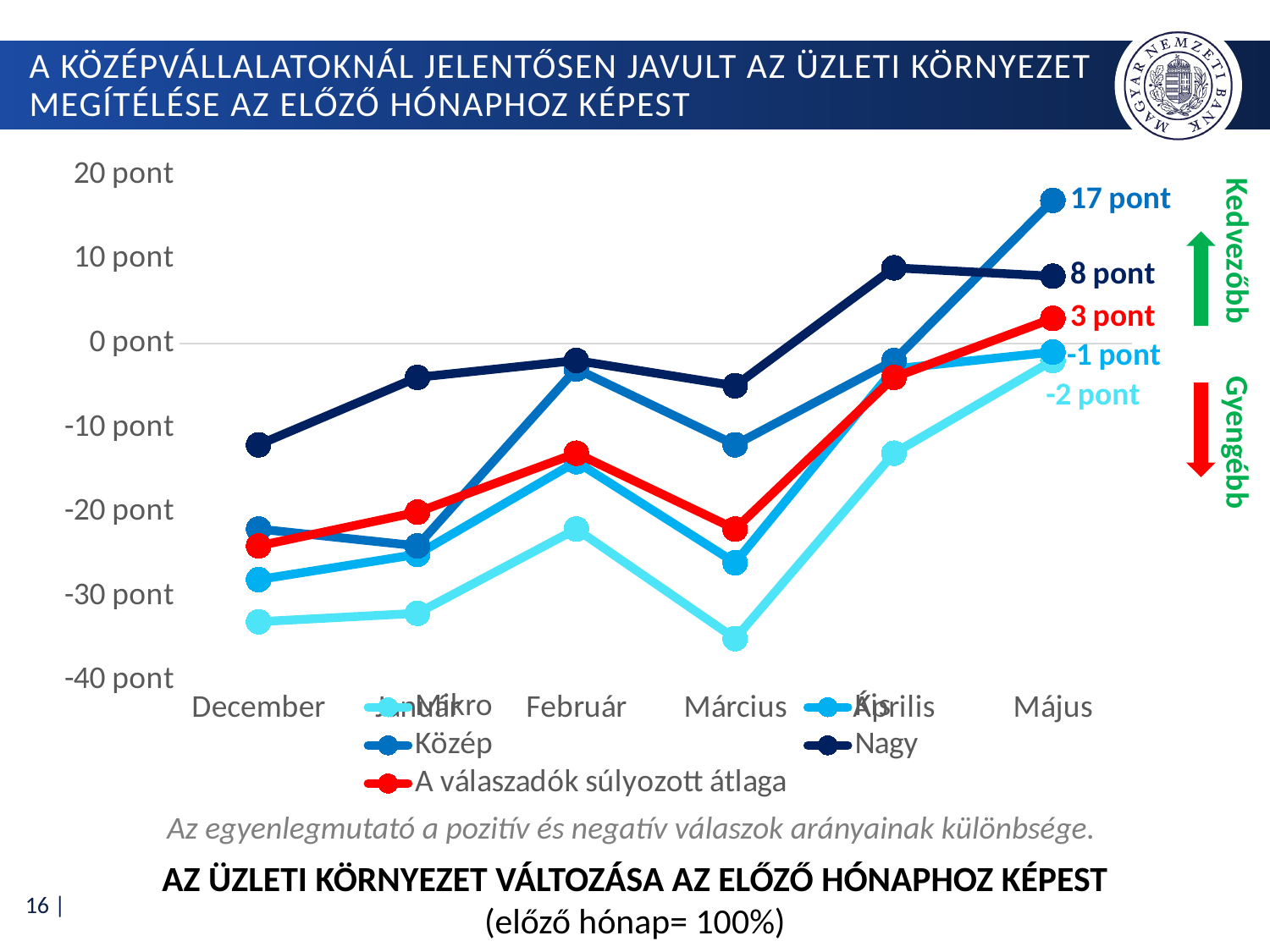
How many series does the chart's legend list? 5 In December, which is larger: the value for Nagy or the value for Mikro? Nagy Which series has the lowest value in Május? Mikro In Május, how much higher is the value for Közép than the value for Nagy? 9 pont How many months are shown along the x axis of the chart? 6 What is the value for 'A válaszadók súlyozott átlaga' in Május? 3 pont Does the Közép series rise or fall from Március to Május? rise What kind of chart is shown on the slide? line chart What is the value for Közép in Május? 17 pont Is the value for Mikro in Március greater or less than -30 pont? less Which series has the highest value in Május? Közép What is the value for Nagy in Május? 8 pont